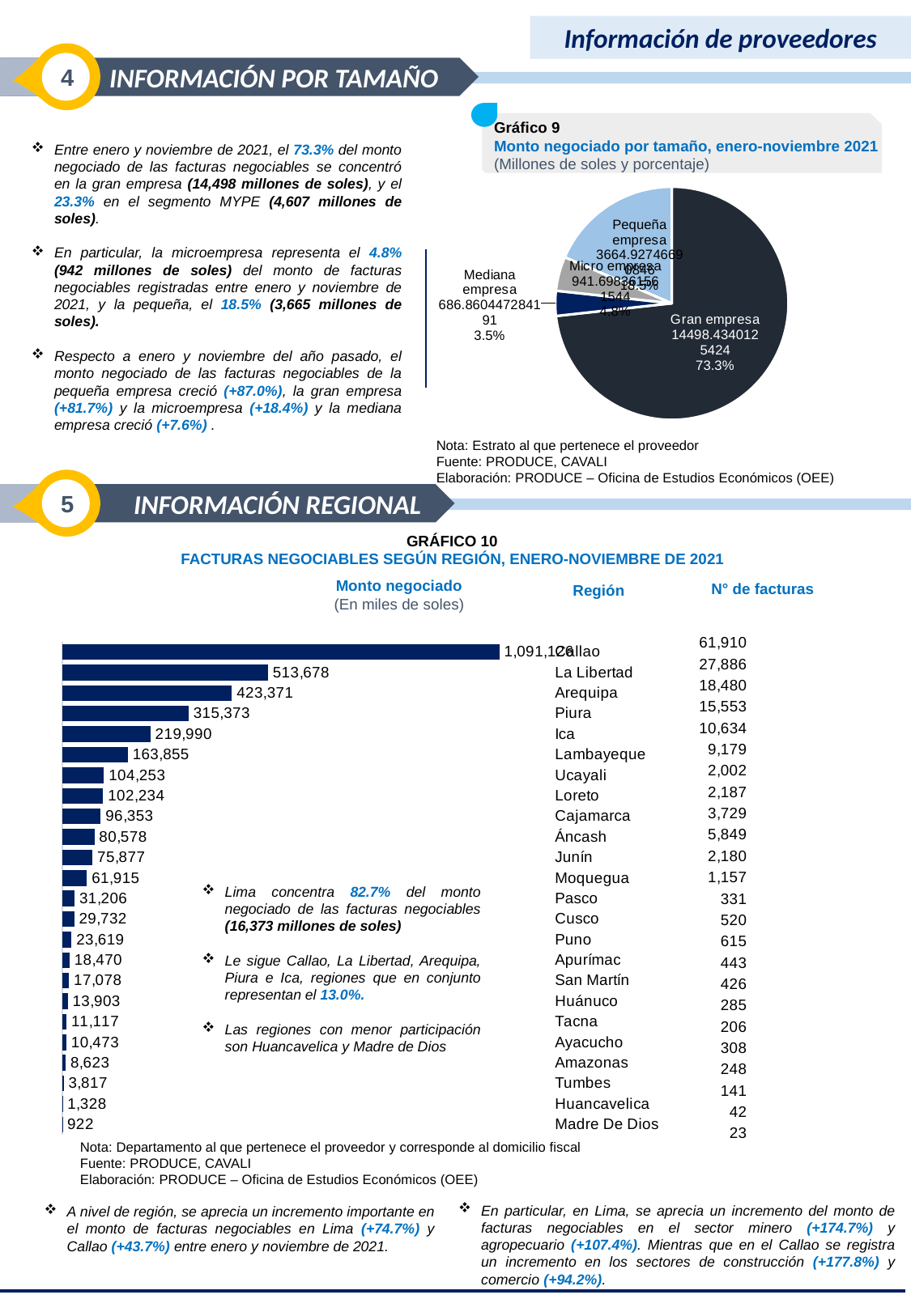
In Gráfico 9, what percentage share does Mediana empresa have? 3.5% In Gráfico 10, how many regions are listed? 24 In Gráfico 10, which has a larger monto negociado, Ucayali or Loreto? Ucayali What kind of chart is Gráfico 10? Bar chart In Gráfico 9, which segment has the largest share? Gran empresa In Gráfico 10, what is the monto negociado for Piura? 315,373 In Gráfico 10, what is the monto negociado for La Libertad? 513,678 In Gráfico 9, what percentage share does Gran empresa have? 73.3% In Gráfico 10, what is the difference in monto negociado between Arequipa and Piura? 107,998 In Gráfico 9, which segment has the smallest share? Mediana empresa What kind of chart is Gráfico 9? Pie chart In Gráfico 10, which region has the lowest monto negociado? Madre De Dios